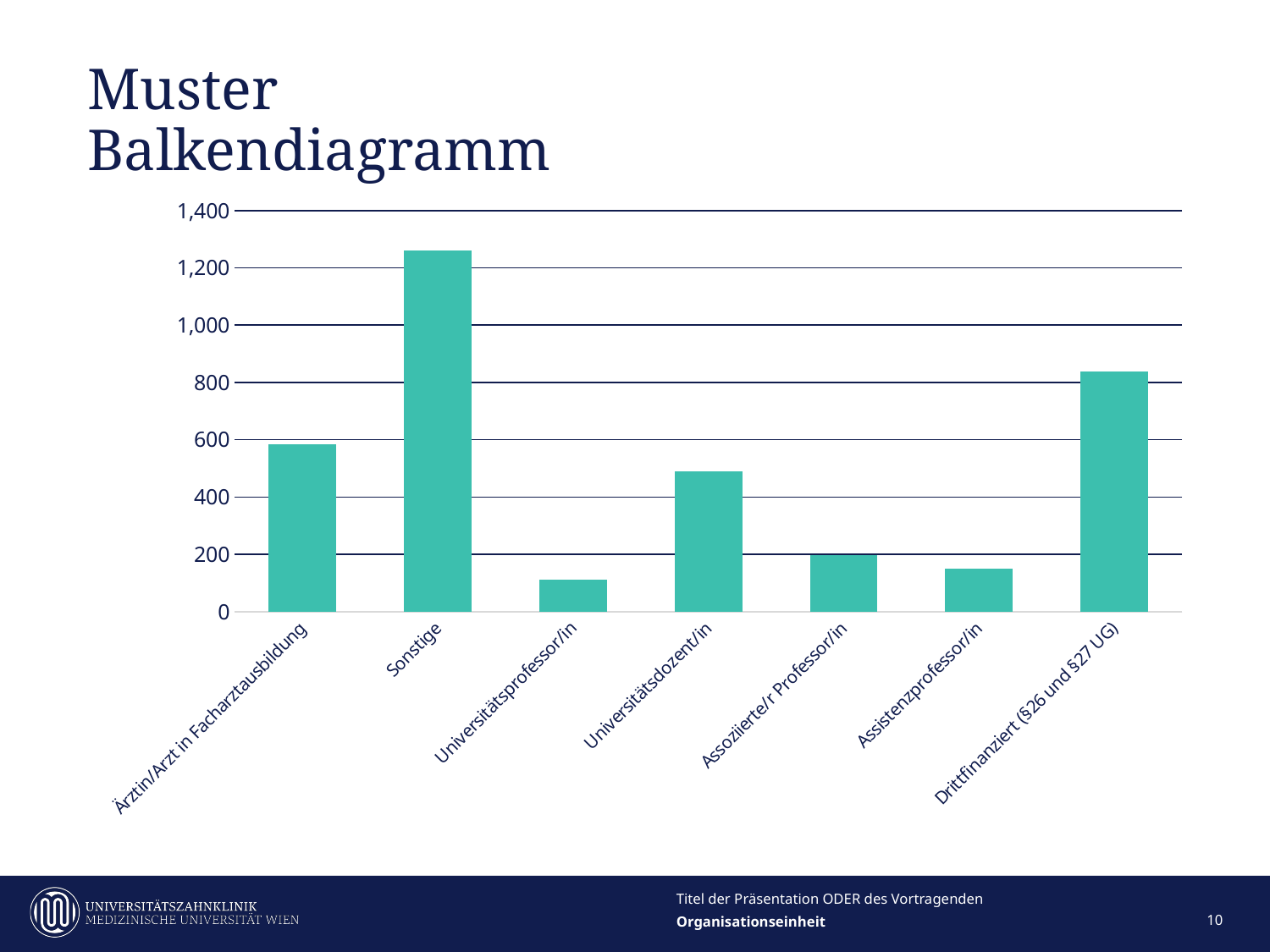
Is the value for Universitätsdozent/in greater or less than 400? greater Is the value for Drittfinanziert (§26 und §27 UG) greater or less than 800? greater What kind of chart is shown on the slide? bar chart Is the value for Assistenzprofessor/in greater or less than 200? less Which category has the highest value in the chart? Sonstige Which is larger, the value for Drittfinanziert (§26 und §27 UG) or the value for Ärztin/Arzt in Facharztausbildung? Drittfinanziert (§26 und §27 UG) Which is larger, the value for Universitätsdozent/in or the value for Assoziierte/r Professor/in? Universitätsdozent/in Which category has the lowest value in the chart? Universitätsprofessor/in What is the title of the slide containing the chart? Muster Balkendiagramm How many categories are shown on the x axis of the chart? 7